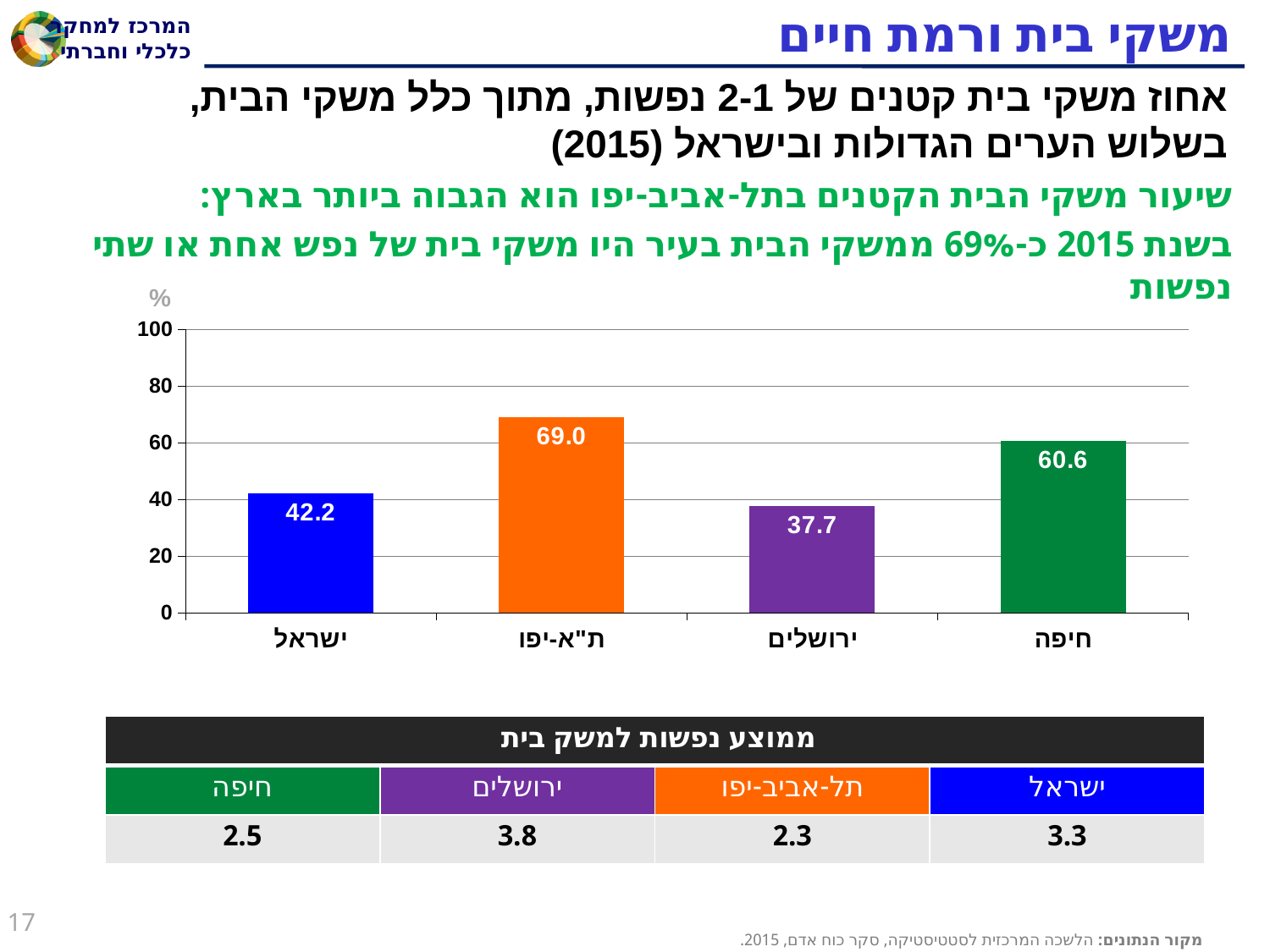
What is the difference between the values for ת"א-יפו and ירושלים? 31.3 What is the value for ירושלים (Jerusalem) in the bar chart? 37.7 What is the value for ישראל (Israel) in the bar chart? 42.2 How many categories are shown on the x axis of the bar chart? 4 What unit label is shown at the top of the y axis of the chart? % What is the difference between the values for חיפה and ישראל? 18.4 What is the value for ת"א-יפו (Tel Aviv-Jaffa) in the bar chart? 69.0 Which is larger, the value for חיפה or the value for ישראל? חיפה What is the value for חיפה (Haifa) in the bar chart? 60.6 Which category has the highest bar in the chart? ת"א-יפו Which category has the lowest bar in the chart? ירושלים What kind of chart is shown on the slide? bar chart